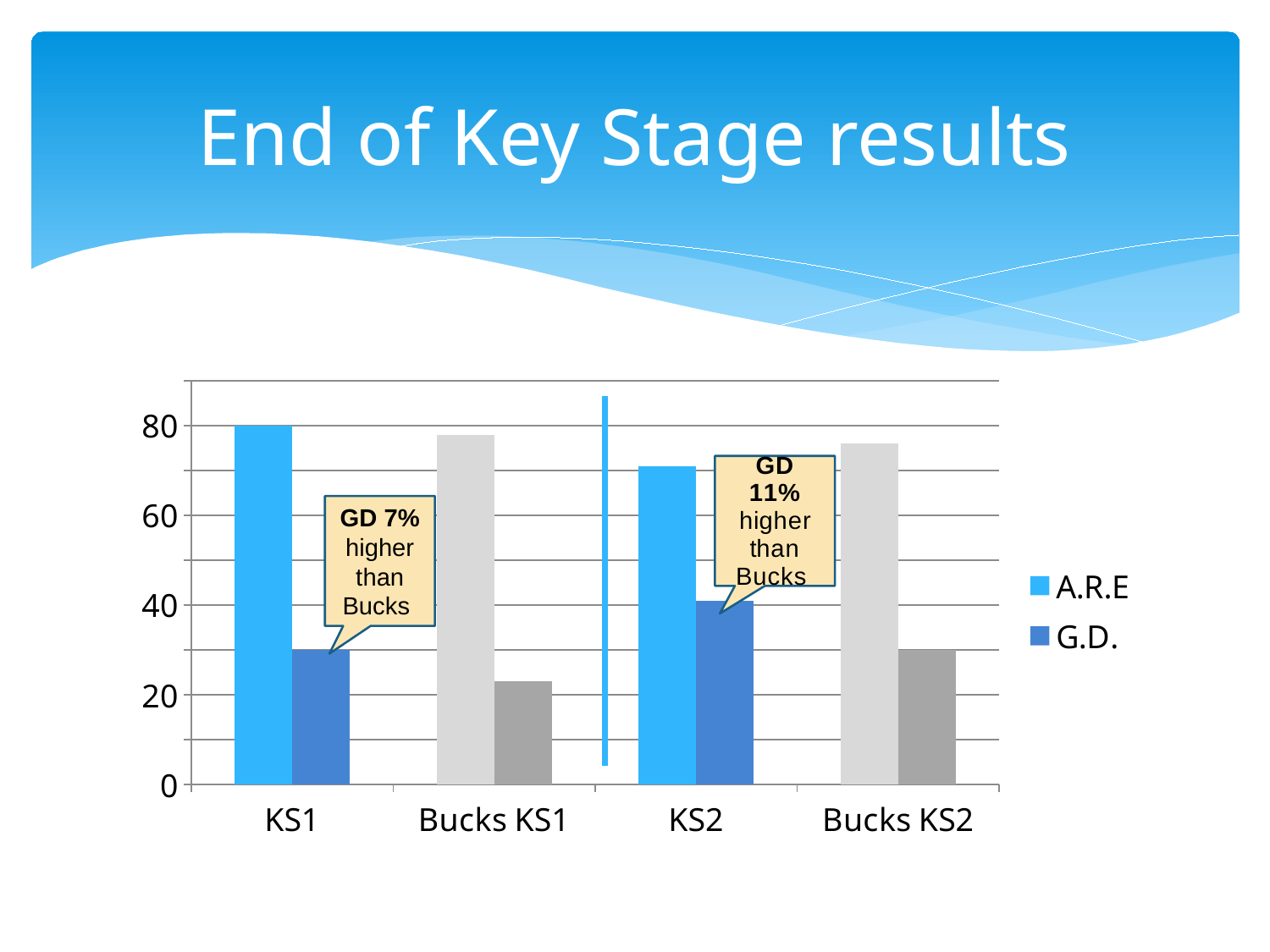
Is the G.D. value for Bucks KS1 greater or less than 40? less Which is larger, the G.D. value for KS1 or the G.D. value for KS2? KS2 How many categories are shown on the x axis? 4 Which category has the lowest A.R.E value? KS2 How many series does the legend list? 2 What is the A.R.E value for KS1? 80 Is the G.D. value for KS1 greater or less than 40? less According to the callout on the KS2 bars, how much higher is GD than Bucks? 11% Which category has the lowest G.D. value? Bucks KS1 Is the A.R.E value for KS2 greater or less than 60? greater Which category has the highest G.D. value? KS2 What kind of chart is shown on the slide? bar chart